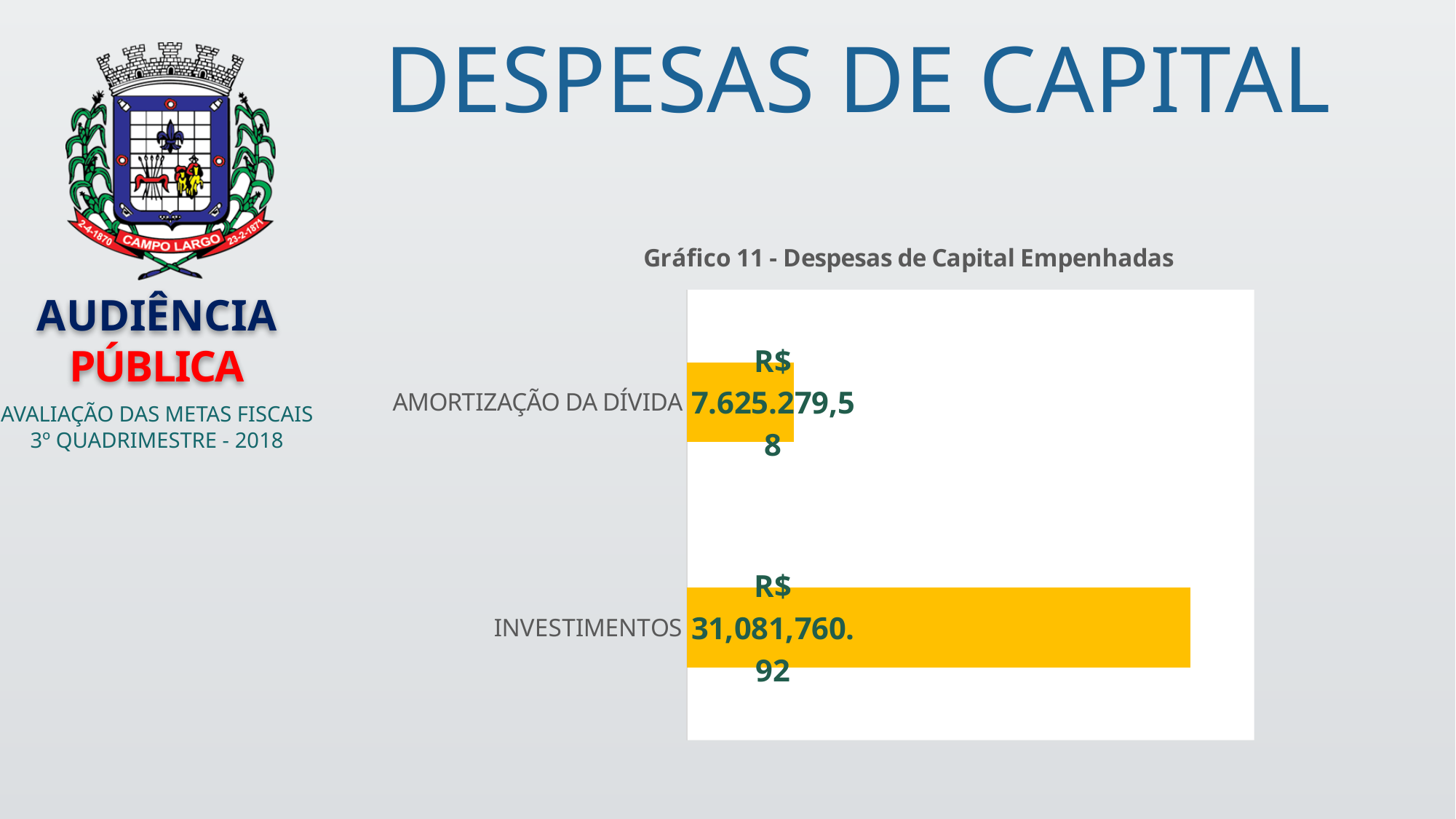
How many categories are shown in the chart? 2 What is the value for INVESTIMENTOS in the chart? R$ 31,081,760.92 What kind of chart is shown on the slide? Bar chart Which is larger, the value for INVESTIMENTOS or the value for AMORTIZAÇÃO DA DÍVIDA? INVESTIMENTOS What is the value for AMORTIZAÇÃO DA DÍVIDA in the chart? R$ 7.625.279,58 Which category has the lowest value in the chart? AMORTIZAÇÃO DA DÍVIDA What colour are the bars in the chart? Yellow What is the title of the chart? Gráfico 11 - Despesas de Capital Empenhadas Which category has the highest value in the chart? INVESTIMENTOS